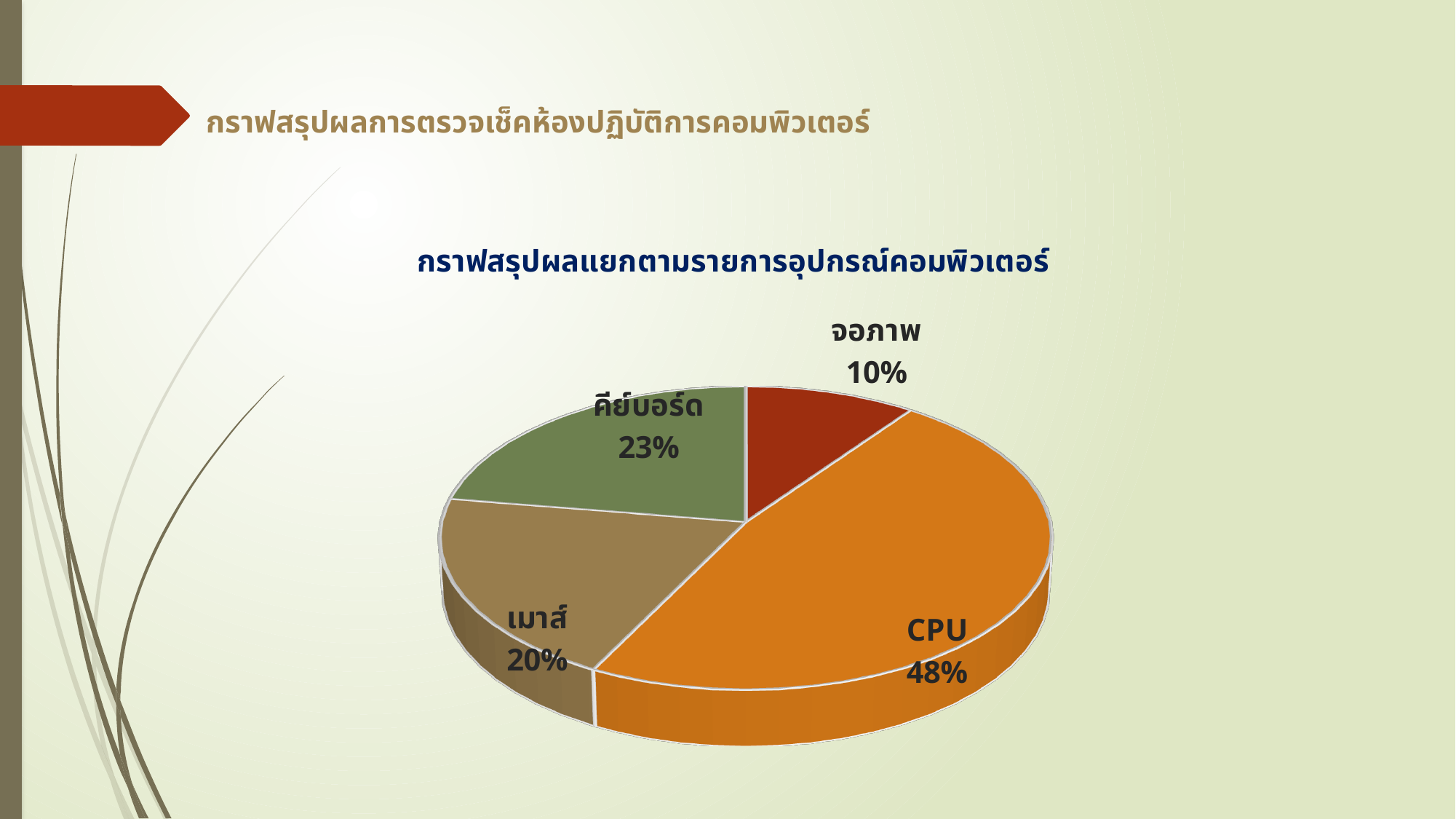
Which is larger, the share for คีย์บอร์ด or the share for เมาส์? คีย์บอร์ด What share of the pie does CPU have? 48% Which category has the smallest slice of the pie? จอภาพ What share of the pie does คีย์บอร์ด have? 23% What kind of chart is shown on the slide? Pie chart What colour is the CPU slice? Orange How many slices does the pie chart have? 4 What is the difference in percentage points between CPU and คีย์บอร์ด? 25 Which category has the largest slice of the pie? CPU What share of the pie does เมาส์ have? 20% What is the chart's title? กราฟสรุปผลแยกตามรายการอุปกรณ์คอมพิวเตอร์